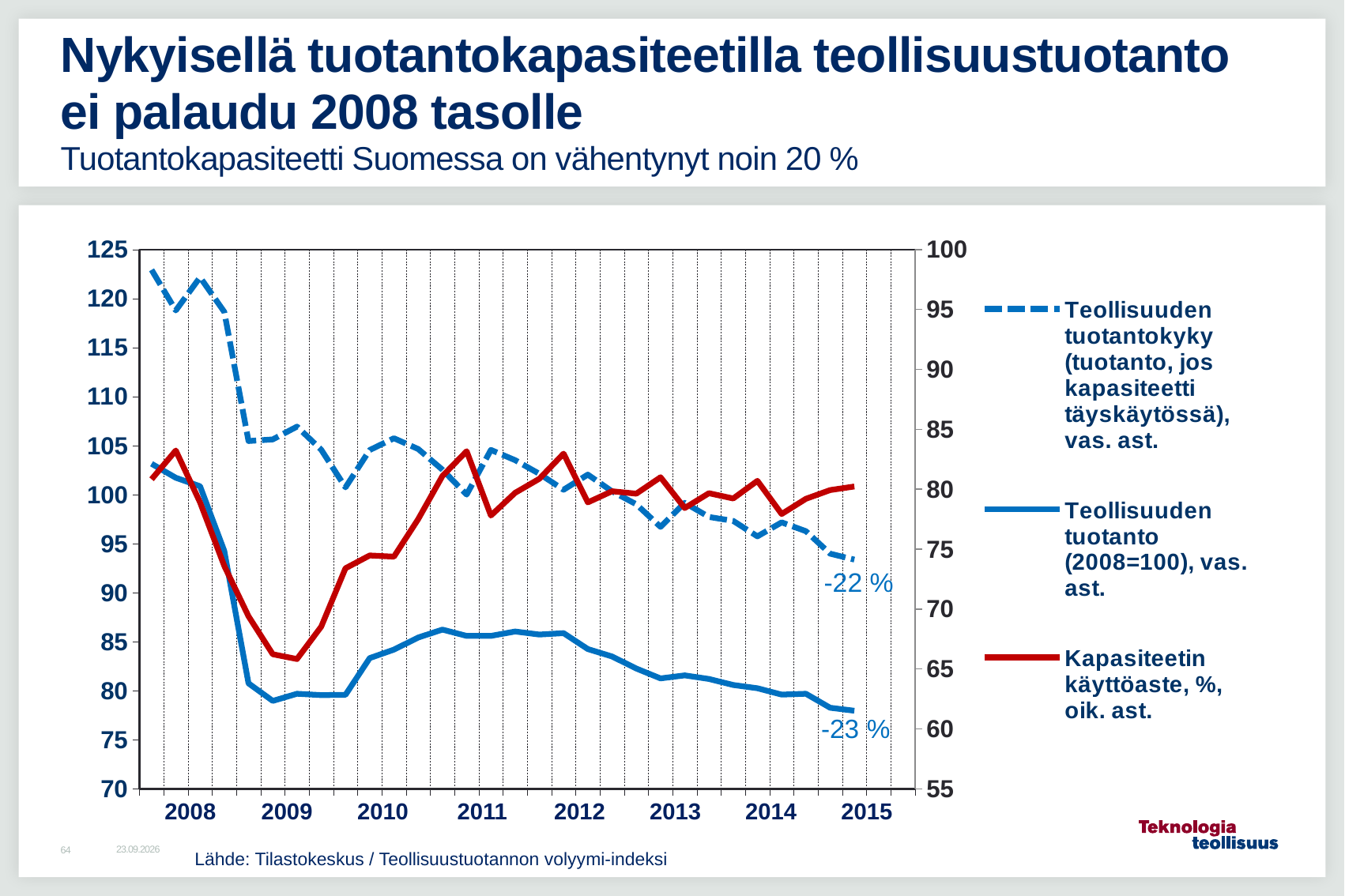
Which series is plotted against the right-hand axis (oik. ast.)? Kapasiteetin käyttöaste, % Is the value of the dashed Teollisuuden tuotantokyky line at the start of 2008 greater or less than 120? greater What percentage change is annotated next to the end of the solid blue Teollisuuden tuotanto line? -23 % Which series is drawn with a dashed line? Teollisuuden tuotantokyky (tuotanto, jos kapasiteetti täyskäytössä), vas. ast. Is the value of the solid blue Teollisuuden tuotanto line at the start of 2015 greater or less than 80? less At the start of 2015, which is higher on the left axis: the dashed Teollisuuden tuotantokyky line or the solid Teollisuuden tuotanto line? Teollisuuden tuotantokyky Does the solid blue Teollisuuden tuotanto line rise or fall overall from 2008 to 2015? fall What is the highest value shown on the left-hand axis? 125 How many series does the legend list? 3 What kind of chart is shown on the slide? line chart What percentage change is annotated next to the end of the dashed Teollisuuden tuotantokyky line? -22 % Is the Kapasiteetin käyttöaste value at its lowest point in 2009 greater or less than 70 on the right axis? less